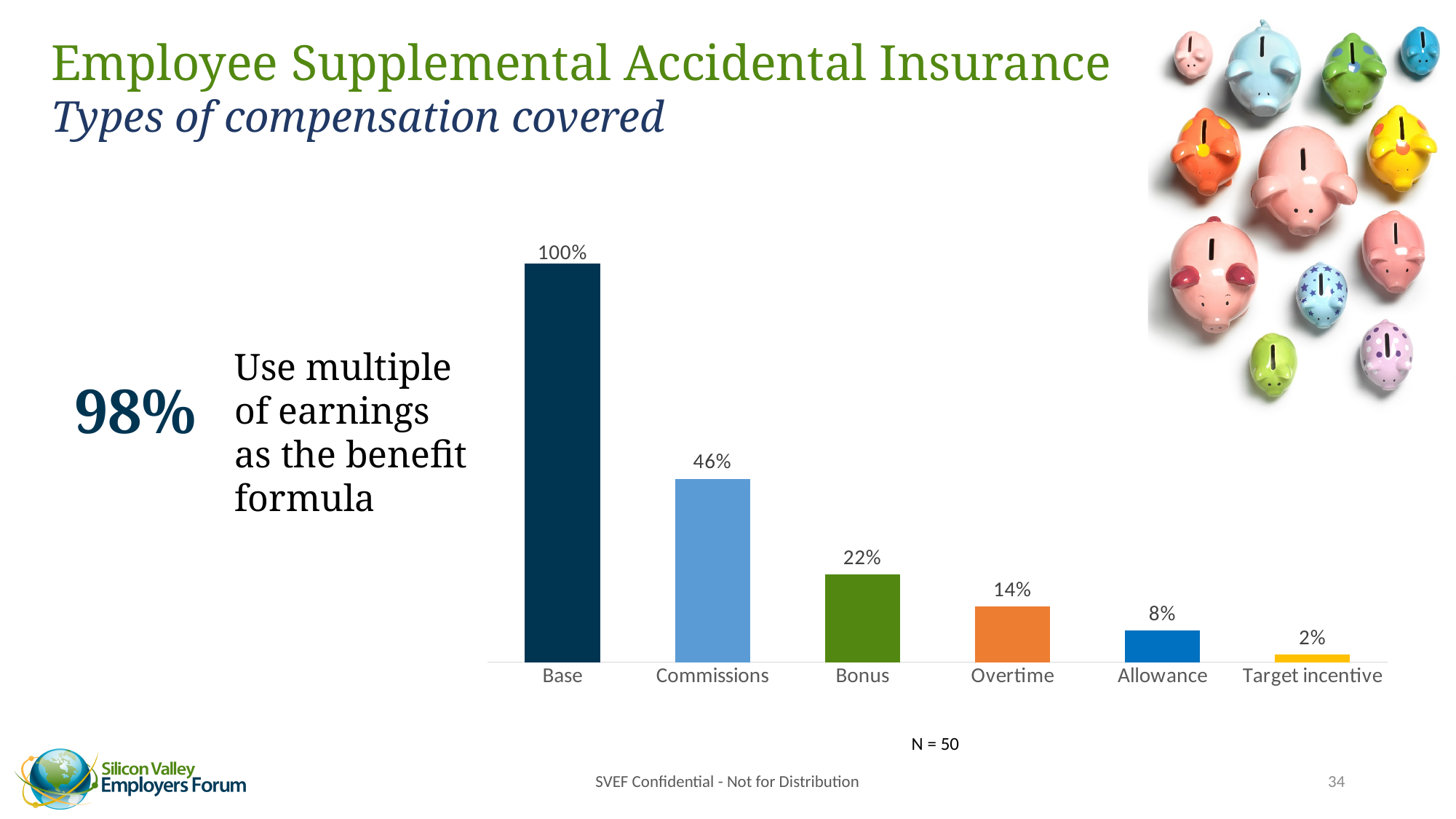
What kind of chart is shown on the slide? Bar chart How many types of compensation are shown in the chart? 6 Do the values rise or fall from left to right across the categories? Fall Which type of compensation has the highest percentage? Base What is the difference in percentage points between Base and Commissions? 54 What percentage is shown for Target incentive? 2% What is the difference in percentage points between Commissions and Bonus? 24 What percentage is shown for Base? 100% Which type of compensation has the lowest percentage? Target incentive Which is larger, the value for Overtime or the value for Allowance? Overtime What percentage is shown for Commissions? 46% What percentage is shown for Overtime? 14%